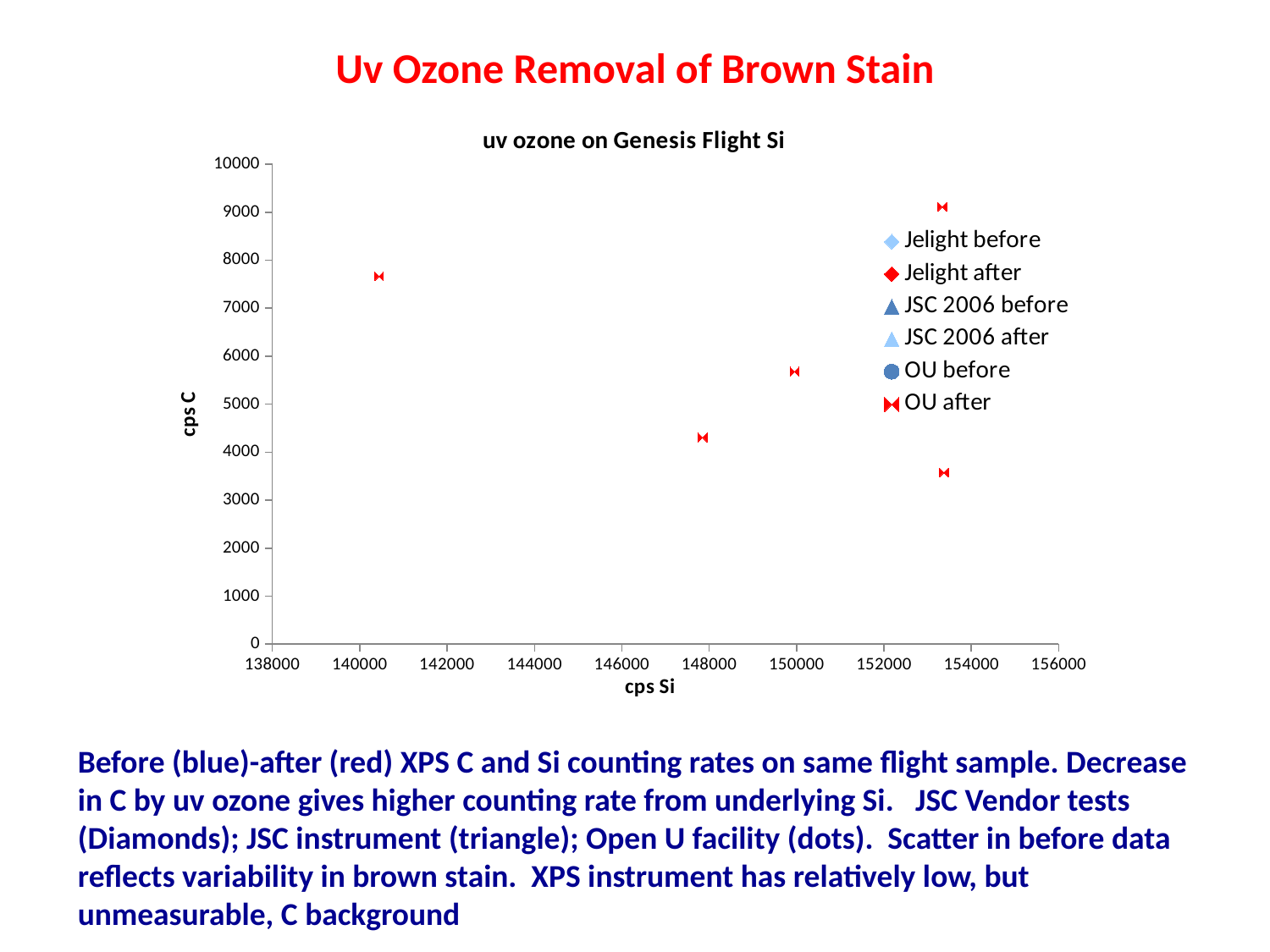
How many plotted points have a cps Si value greater than 152000? 2 What is the title of the chart? uv ozone on Genesis Flight Si What is the maximum value shown on the y axis of the chart? 10000 How many plotted points have a cps C value greater than 8000? 1 What kind of chart is shown on the slide? scatter chart How many series does the chart legend list? 6 Is the cps C value of the lowest plotted point greater or less than 3000? greater How many data points are plotted on the chart? 5 Is the cps C value of the lowest plotted point greater or less than 4000? less Is the cps C value of the point plotted near 148000 cps Si greater or less than 5000? less What is the label on the x axis of the chart? cps Si